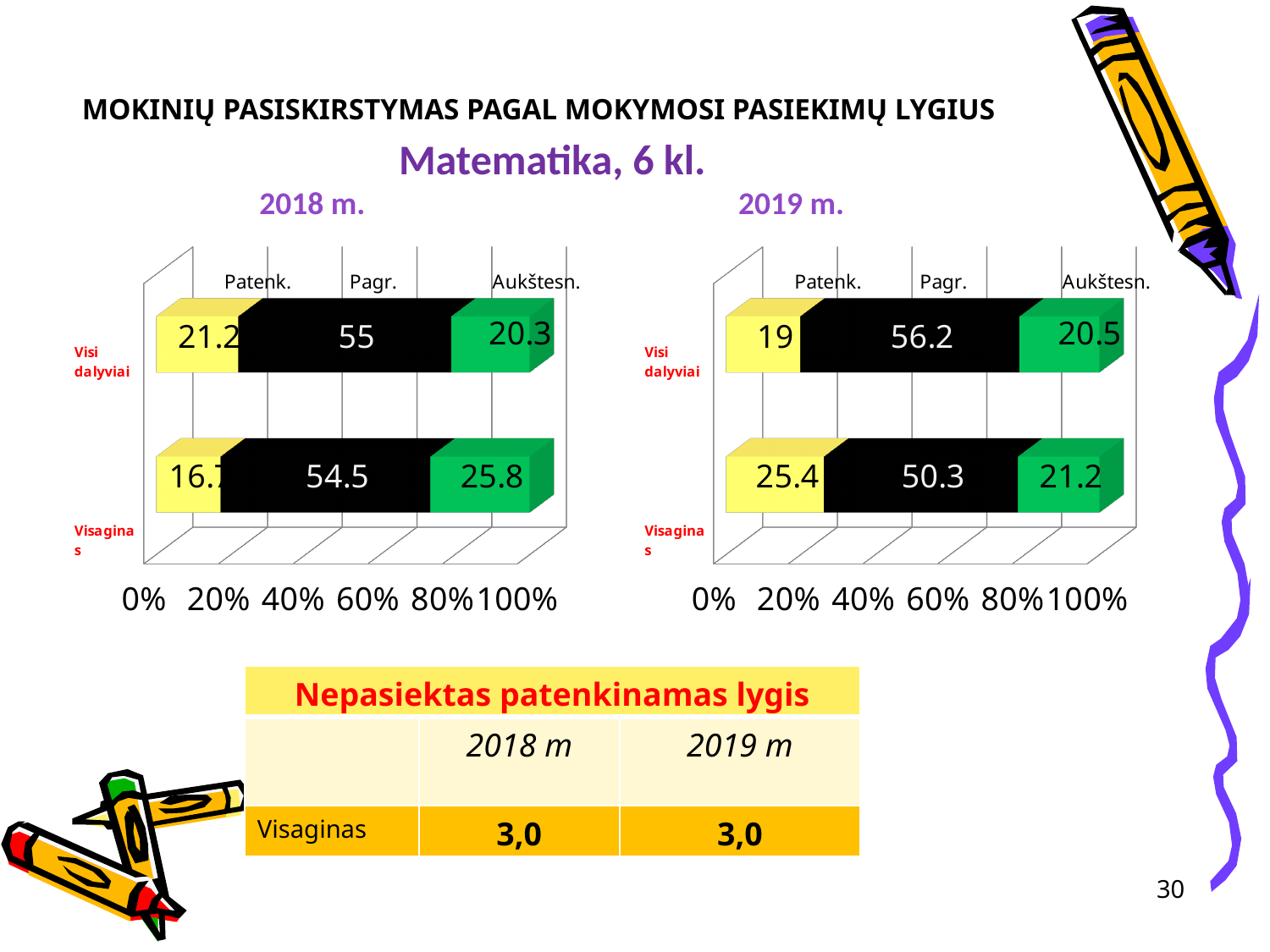
In the 2019 m. chart, what is the Patenk. value for Visaginas? 25.4 In the 2019 m. chart, what is the Aukštesn. value for Visi dalyviai? 20.5 In the 2018 m. chart, what is the Pagr. value for Visi dalyviai? 55 In the 2019 m. chart, what is the difference between the Pagr. values for Visi dalyviai and Visaginas? 5.9 In the 2019 m. chart, what is the total of the stacked bar for Visi dalyviai? 95.7 What kind of chart is the 2019 m. chart? Stacked bar chart In the 2019 m. chart, which series has the lowest value for Visi dalyviai? Patenk. In the 2018 m. chart, which is larger for Visaginas: the Patenk. value or the Aukštesn. value? Aukštesn. In the 2019 m. chart, what is the Pagr. value for Visi dalyviai? 56.2 How many series does the 2018 m. chart show? 3 In the 2018 m. chart, what is the Aukštesn. value for Visaginas? 25.8 In the 2019 m. chart, which series has the highest value for Visaginas? Pagr.